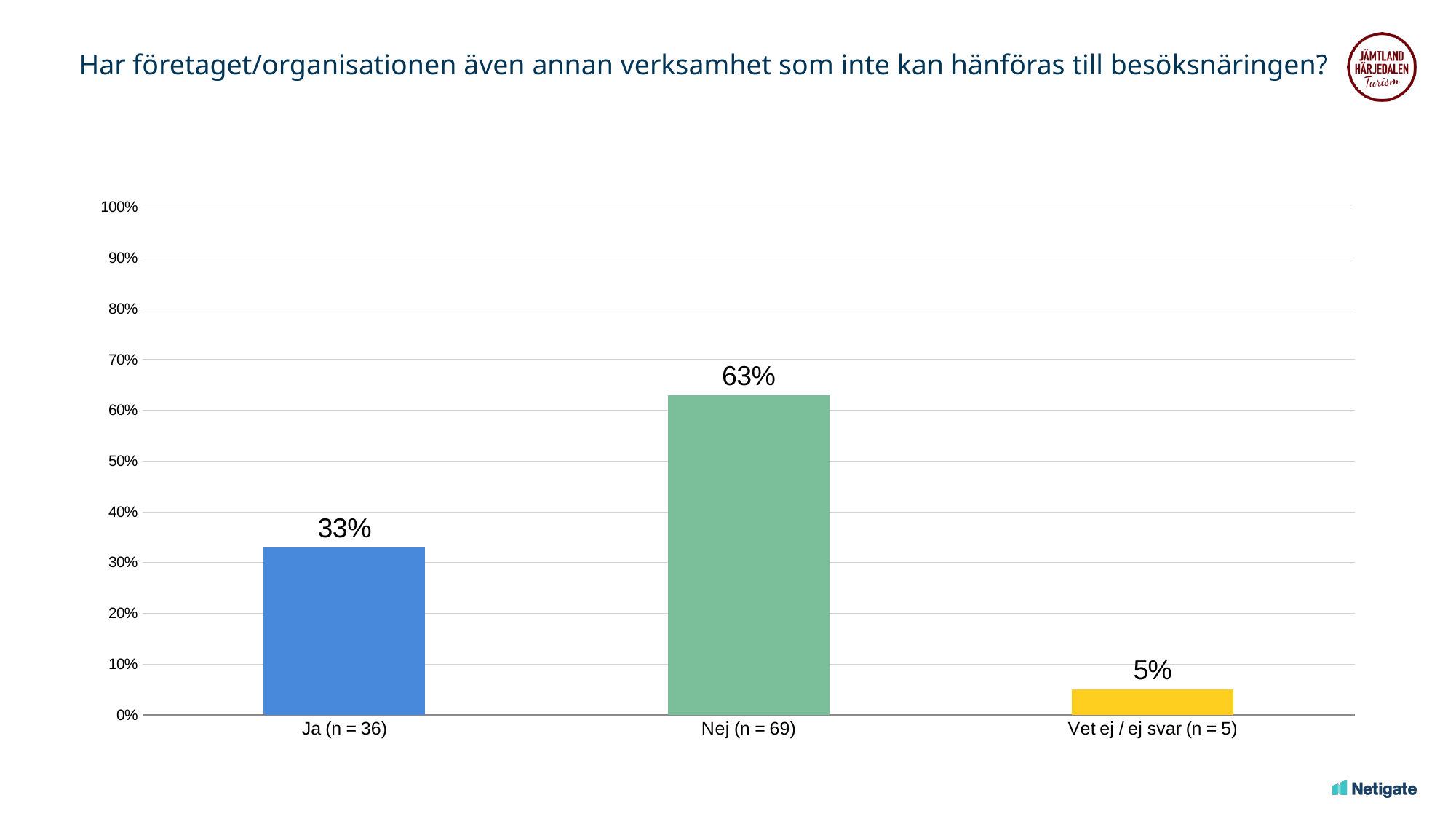
What is the difference between the values for Ja (n = 36) and Vet ej / ej svar (n = 5)? 28% What kind of chart is shown on the slide? bar chart What is the difference between the values for Nej (n = 69) and Ja (n = 36)? 30% What colour is the bar for Nej (n = 69)? green Which category has the highest value? Nej (n = 69) Which is larger, the value for Ja (n = 36) or the value for Nej (n = 69)? Nej (n = 69) What is the value for Vet ej / ej svar (n = 5)? 5% What is the value for Nej (n = 69)? 63% Which category has the lowest value? Vet ej / ej svar (n = 5) Is the value for Nej (n = 69) greater or less than 50%? greater How many categories are shown on the x axis? 3 What is the value for Ja (n = 36)? 33%